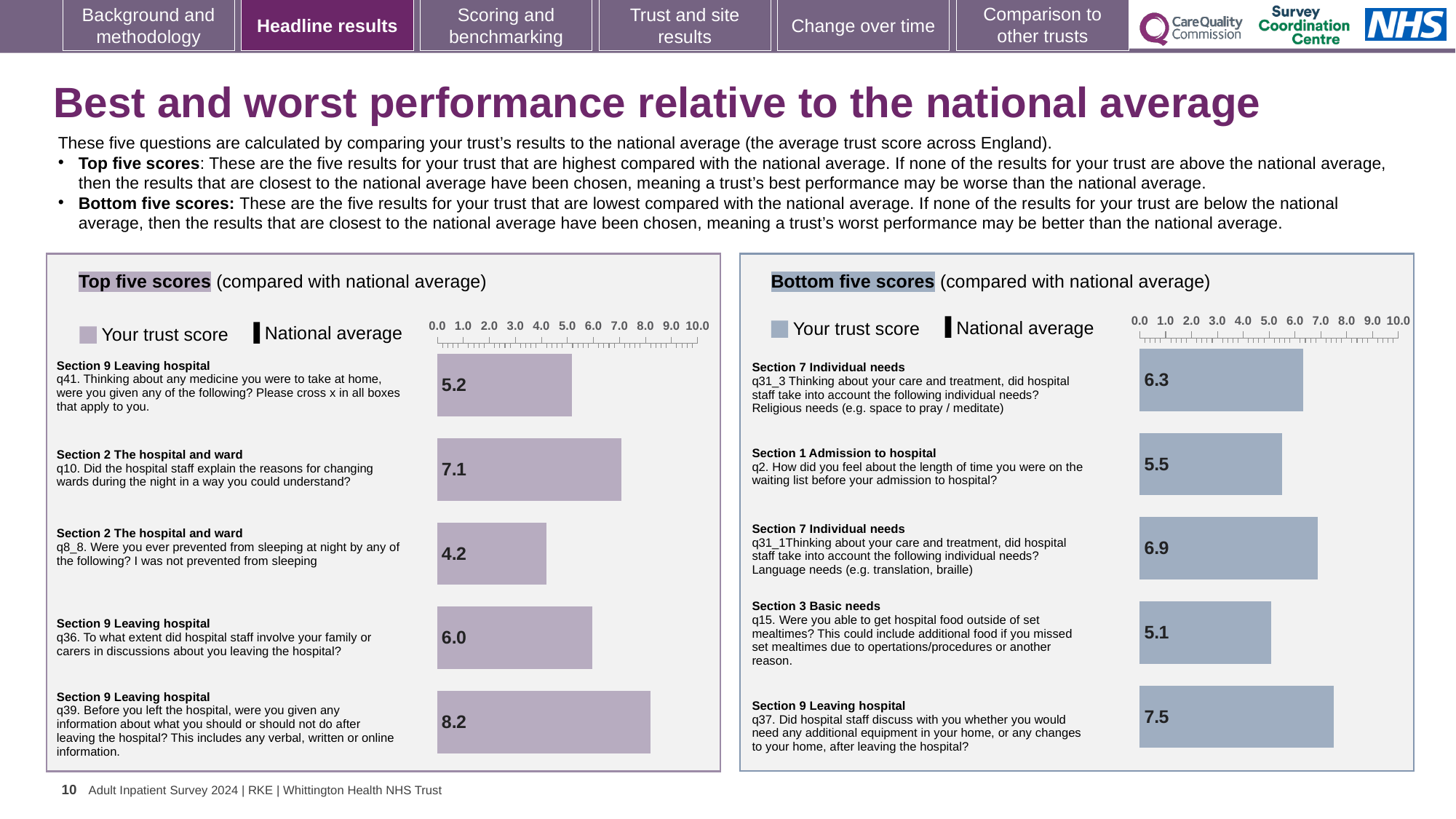
In the Top five scores chart, which question has the highest trust score? q39 (8.2) In the Bottom five scores chart, which question has the highest trust score? q37 (7.5) In the Top five scores chart, which question has the lowest trust score? q8_8 (4.2) In the Top five scores chart, what is the difference between the trust scores for q10 and q41? 1.9 What kind of chart is the Bottom five scores chart? Bar chart How many bars are plotted in the Top five scores chart? 5 In the Bottom five scores chart, which question has the lowest trust score? q15 (5.1) In the Top five scores chart, what is the trust score for q39 (information about what you should or should not do after leaving the hospital)? 8.2 How many series does the legend of the Top five scores chart list? 2 In the Bottom five scores chart, which has the larger trust score: q31_3 (religious needs) or q31_1 (language needs)? q31_1 (language needs) In the Bottom five scores chart, what is the trust score for q2 (how did you feel about the length of time on the waiting list before admission)? 5.5 In the Bottom five scores chart, what is the difference between the trust scores for q37 and q15? 2.4